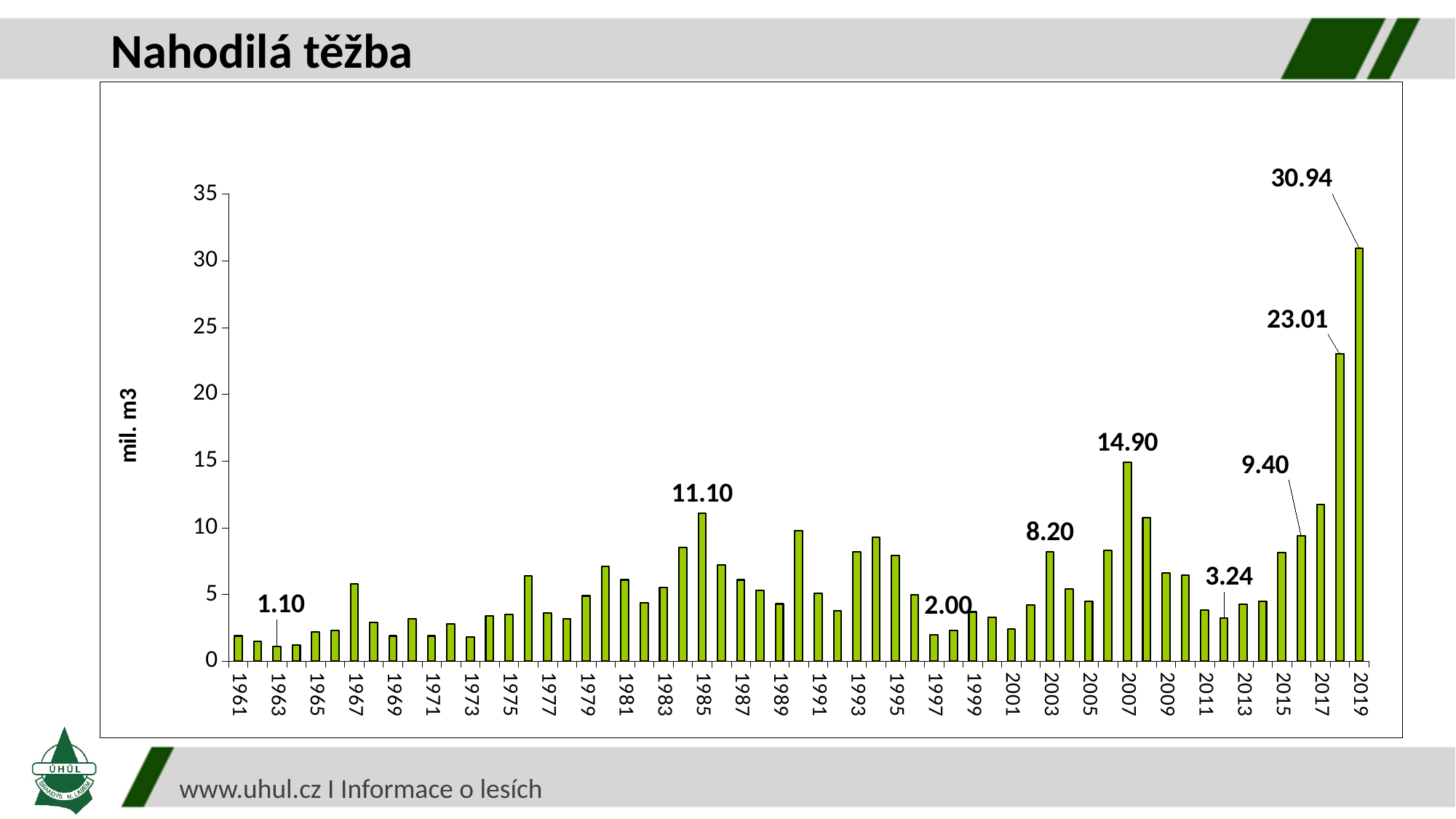
What is the value for 2019? 30.94 What is the difference between the values for 2007 and 2003? 6.70 What kind of chart is shown? bar chart What is the label on the vertical axis? mil. m3 Is the value for 1967 greater or less than 10? less What is the value for 2007? 14.90 What is the value for 2018? 23.01 What is the value for 1985? 11.10 Do the values rise or fall from 2015 to 2019? rise What is the difference between the values for 2019 and 2018? 7.93 Which is larger, the value for 2007 or the value for 1985? 2007 Which year has the highest value? 2019